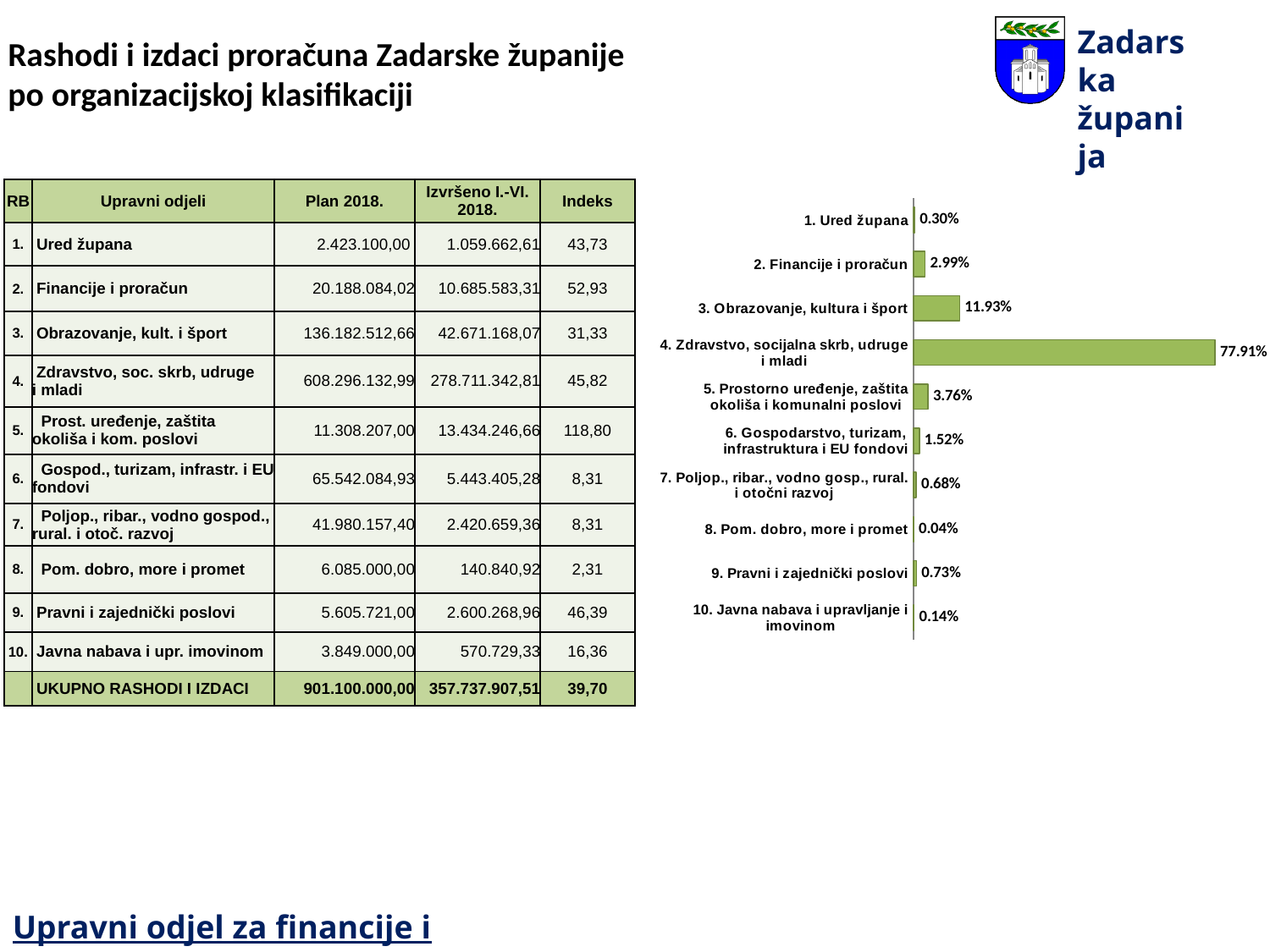
Which category has the highest value in the bar chart? 4. Zdravstvo, socijalna skrb, udruge i mladi What is the value shown for '4. Zdravstvo, socijalna skrb, udruge i mladi' in the bar chart? 77.91% What colour are the bars in the chart? Green Which category has the lowest value in the bar chart? 8. Pom. dobro, more i promet What is the difference between the values for '5. Prostorno uređenje, zaštita okoliša i komunalni poslovi' and '2. Financije i proračun' in the bar chart? 0.77% What is the value shown for '8. Pom. dobro, more i promet' in the bar chart? 0.04% How many categories are shown in the bar chart? 10 What is the value shown for '3. Obrazovanje, kultura i šport' in the bar chart? 11.93% What type of chart is shown on the slide? Bar chart Which has a larger value in the bar chart: '2. Financije i proračun' or '5. Prostorno uređenje, zaštita okoliša i komunalni poslovi'? 5. Prostorno uređenje, zaštita okoliša i komunalni poslovi What is the difference between the values for '4. Zdravstvo, socijalna skrb, udruge i mladi' and '3. Obrazovanje, kultura i šport' in the bar chart? 65.98% What is the value shown for '5. Prostorno uređenje, zaštita okoliša i komunalni poslovi' in the bar chart? 3.76%